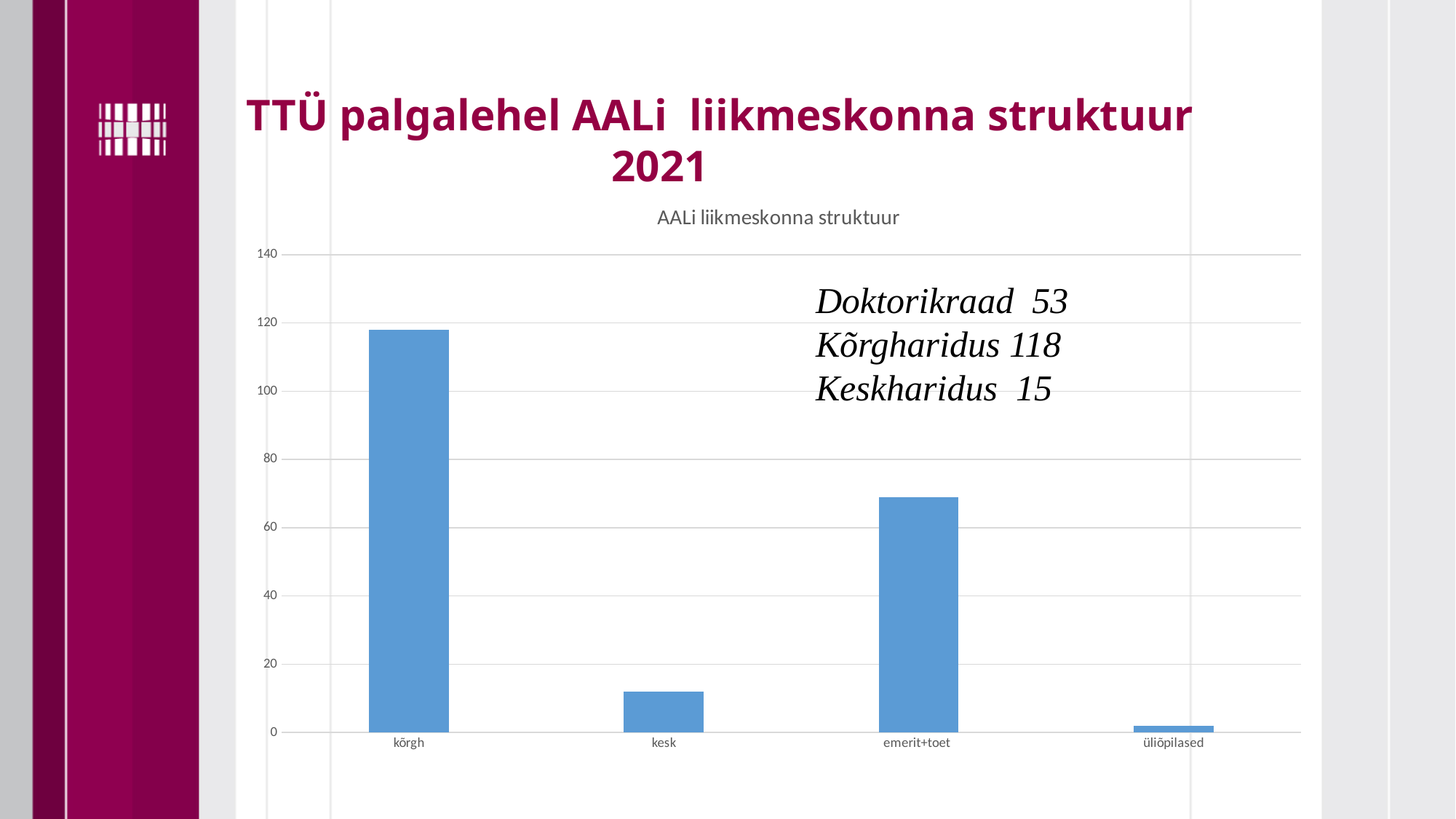
Is the value for emerit+toet greater or less than 60? greater What is the highest value shown on the vertical axis of the chart? 140 Which is larger, the value for emerit+toet or the value for kesk? emerit+toet What is the title of the chart? AALi liikmeskonna struktuur What kind of chart is shown on the slide? bar chart Is the value for kesk greater or less than 20? less Which is larger, the value for kõrgh or the value for emerit+toet? kõrgh Is the value for kõrgh greater or less than 100? greater How many categories are shown on the x axis of the chart? 4 Which category has the highest bar? kõrgh Which category has the lowest bar? üliõpilased